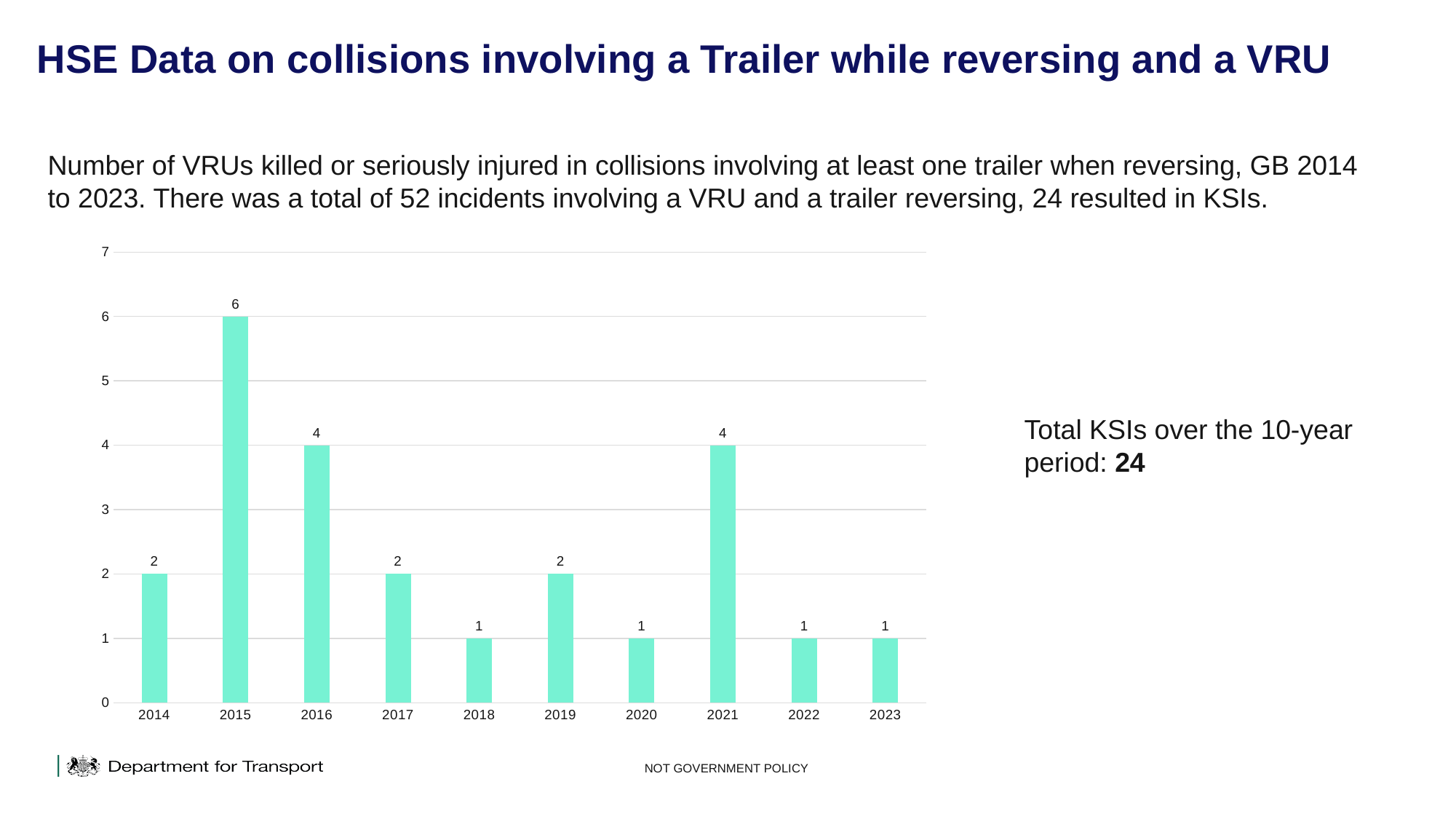
What kind of chart is shown on the slide? bar chart Which is larger, the value for 2014 or the value for 2016? 2016 Is the value for 2015 greater or less than 5? greater What is the value for 2015? 6 How many years are shown on the x axis? 10 What is the difference between the values for 2015 and 2016? 2 What is the value for 2021? 4 Do the values rise or fall from 2021 to 2022? fall What is the highest value shown on the y axis? 7 What is the difference between the values for 2021 and 2022? 3 What is the value for 2018? 1 Which year has the highest value? 2015